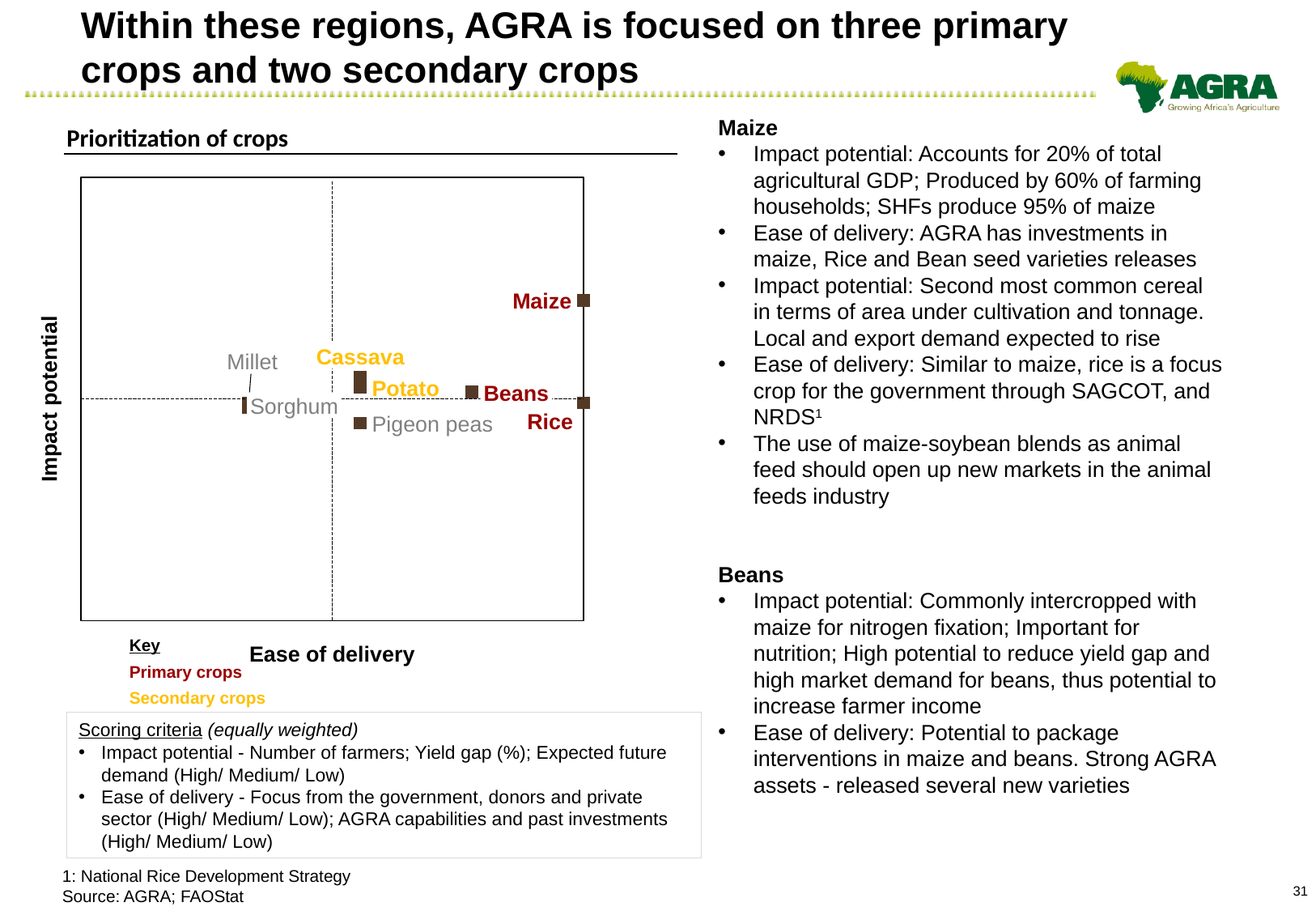
On the 'Prioritization of crops' chart, which has the higher impact potential, Maize or Rice? Maize Which crop has the lowest impact potential on the 'Prioritization of crops' chart? Pigeon peas On the 'Prioritization of crops' chart, which has the higher ease of delivery, Rice or Sorghum? Rice How many crops are plotted on the 'Prioritization of crops' chart? 8 What is the label of the vertical axis on the 'Prioritization of crops' chart? Impact potential Which crop has the highest impact potential on the 'Prioritization of crops' chart? Maize What is the label of the horizontal axis on the 'Prioritization of crops' chart? Ease of delivery What kind of chart is used in the 'Prioritization of crops' figure? Scatter chart On the 'Prioritization of crops' chart, which has the higher ease of delivery, Beans or Millet? Beans How many categories does the key of the 'Prioritization of crops' chart list? 2